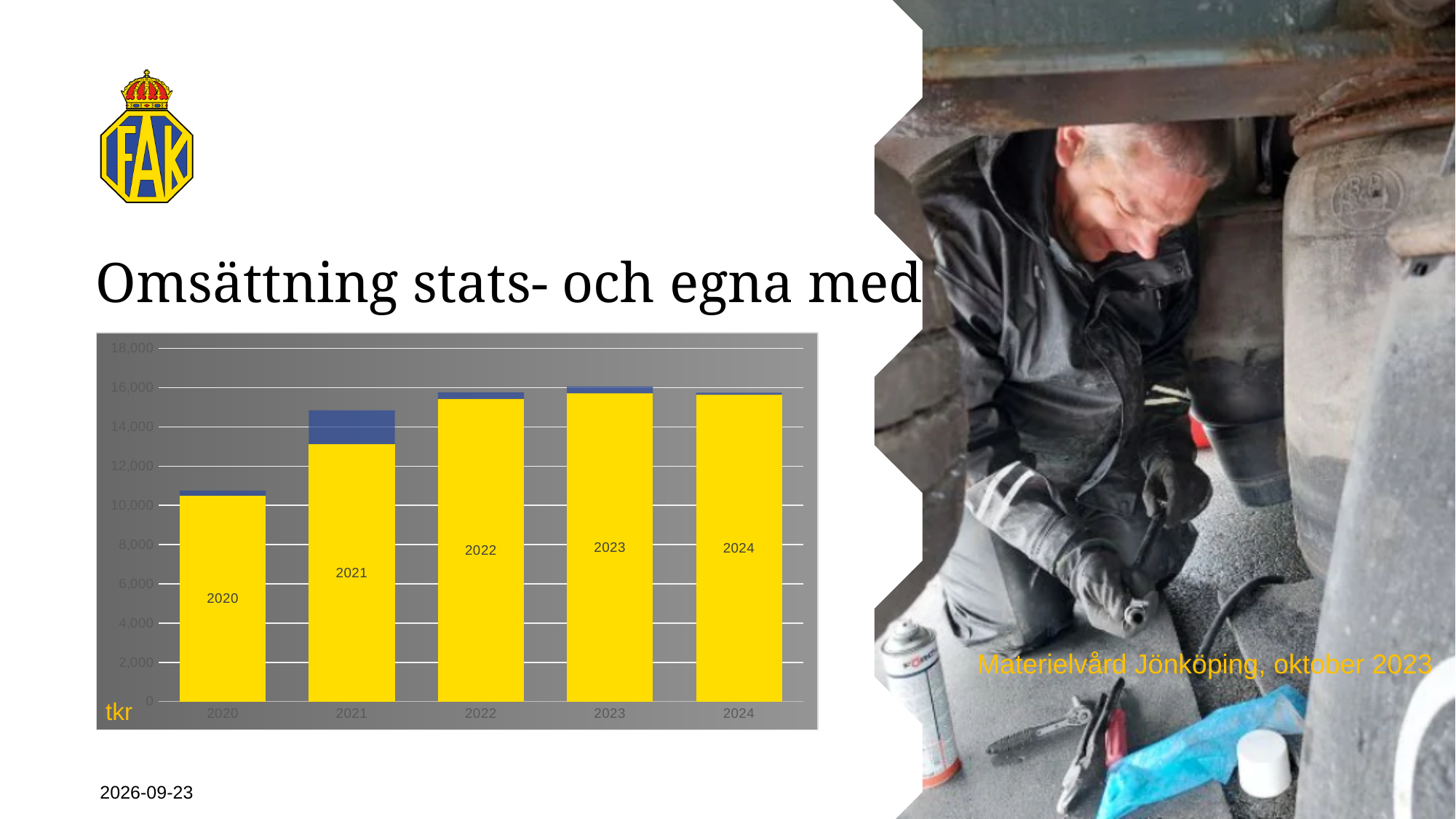
Is the total value for 2021 greater or less than 14,000? greater Is the total value for 2020 greater or less than 12,000? less How many years (categories) are shown on the x axis of the chart? 5 Is the total value for 2023 greater or less than 18,000? less Which year has the largest blue segment in the chart? 2021 Which year has the lowest total bar in the chart? 2020 Do the total bar values rise or fall from 2020 to 2023? rise What unit label is shown at the bottom left of the chart's y axis? tkr Which bar is taller in total, 2020 or 2021? 2021 What kind of chart is shown on the slide? Stacked bar chart